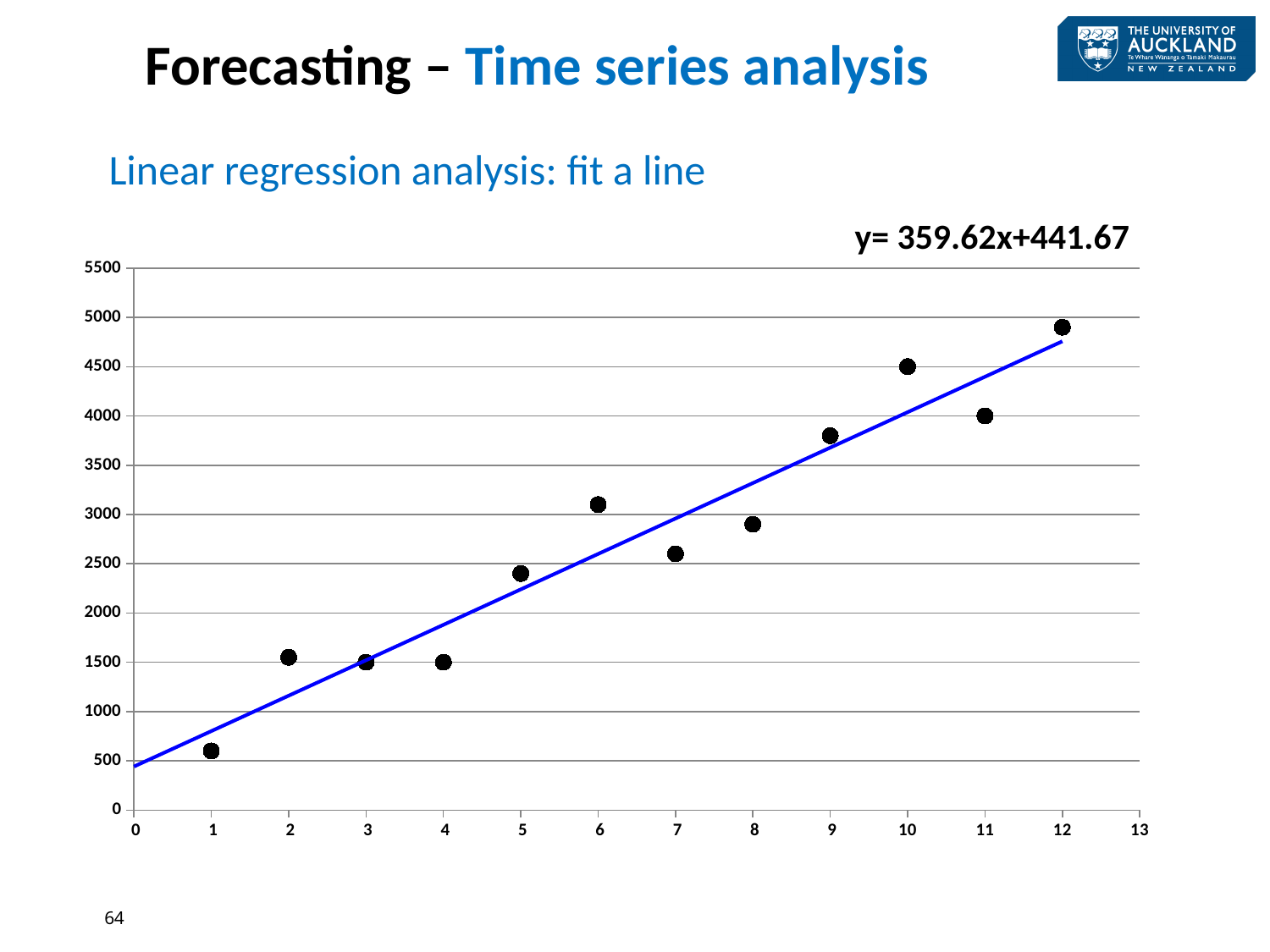
Which point has the larger value, the one at x = 10 or the one at x = 11? x = 10 How many data points are plotted on the chart? 12 At which x value is the plotted point lowest? 1 Is the value of the point at x = 1 greater or less than 1000? less What is the equation of the fitted line shown above the chart? y= 359.62x+441.67 Is the value of the point at x = 6 greater or less than 3000? greater Is the value of the point at x = 7 greater or less than 3000? less What kind of chart is shown on the slide? Scatter plot with a fitted line At which x value is the plotted point highest? 12 Do the plotted values generally rise or fall as x increases from 1 to 12? Rise Which point has the larger value, the one at x = 6 or the one at x = 7? x = 6